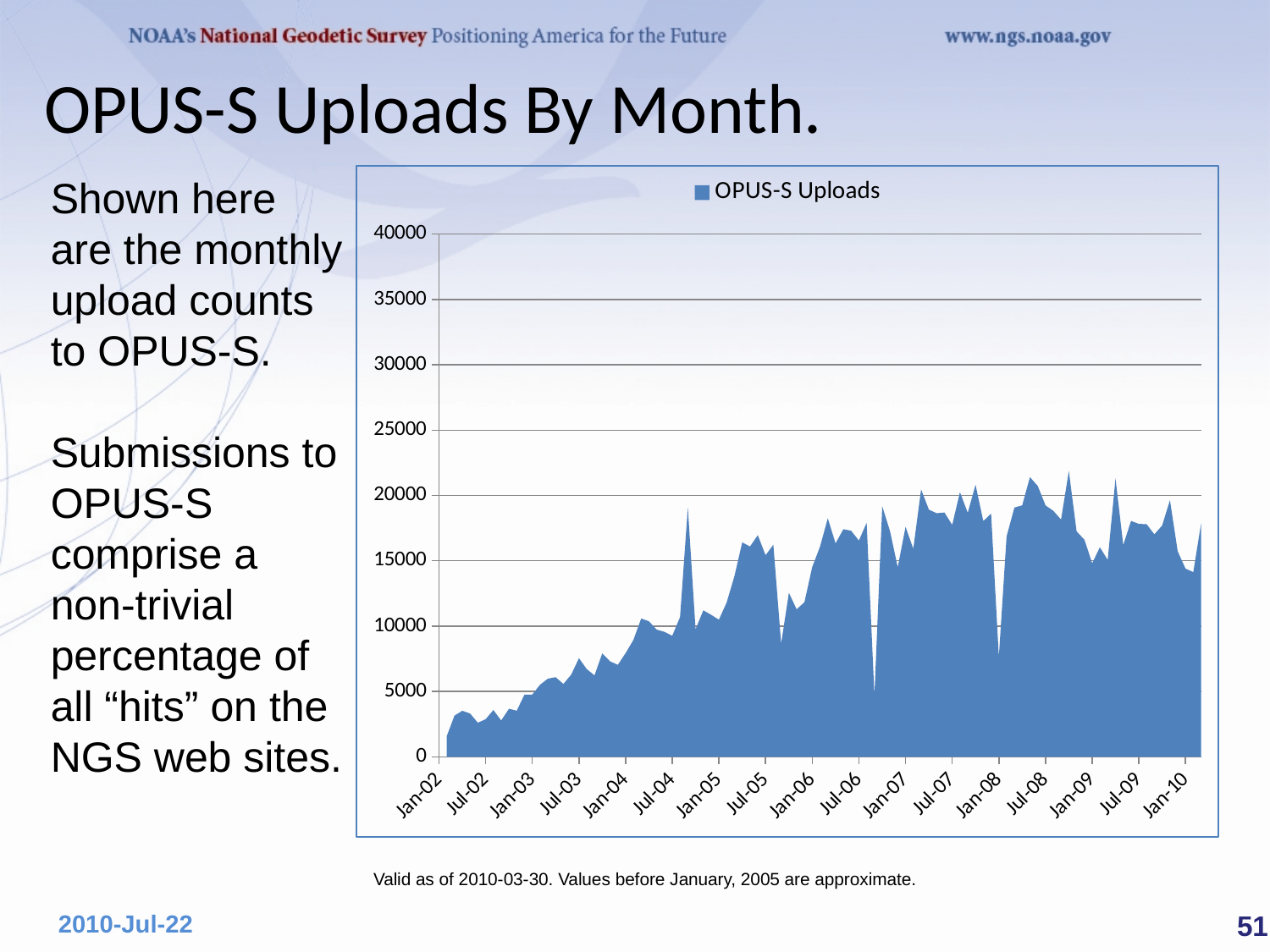
Overall, do the OPUS-S upload values rise or fall from Jan-02 to Jan-10? Rise What is the name of the series shown in the chart legend? OPUS-S Uploads How many month labels are shown along the x axis? 17 How many series does the chart legend list? 1 Which labelled month on the x axis has the lowest upload value? Jan-02 Is the highest value on the chart greater or less than 25000? less Is the value for Jan-02 greater or less than 5000? less What type of chart is shown on the slide? Area chart Is the value for Jan-04 greater or less than 5000? greater